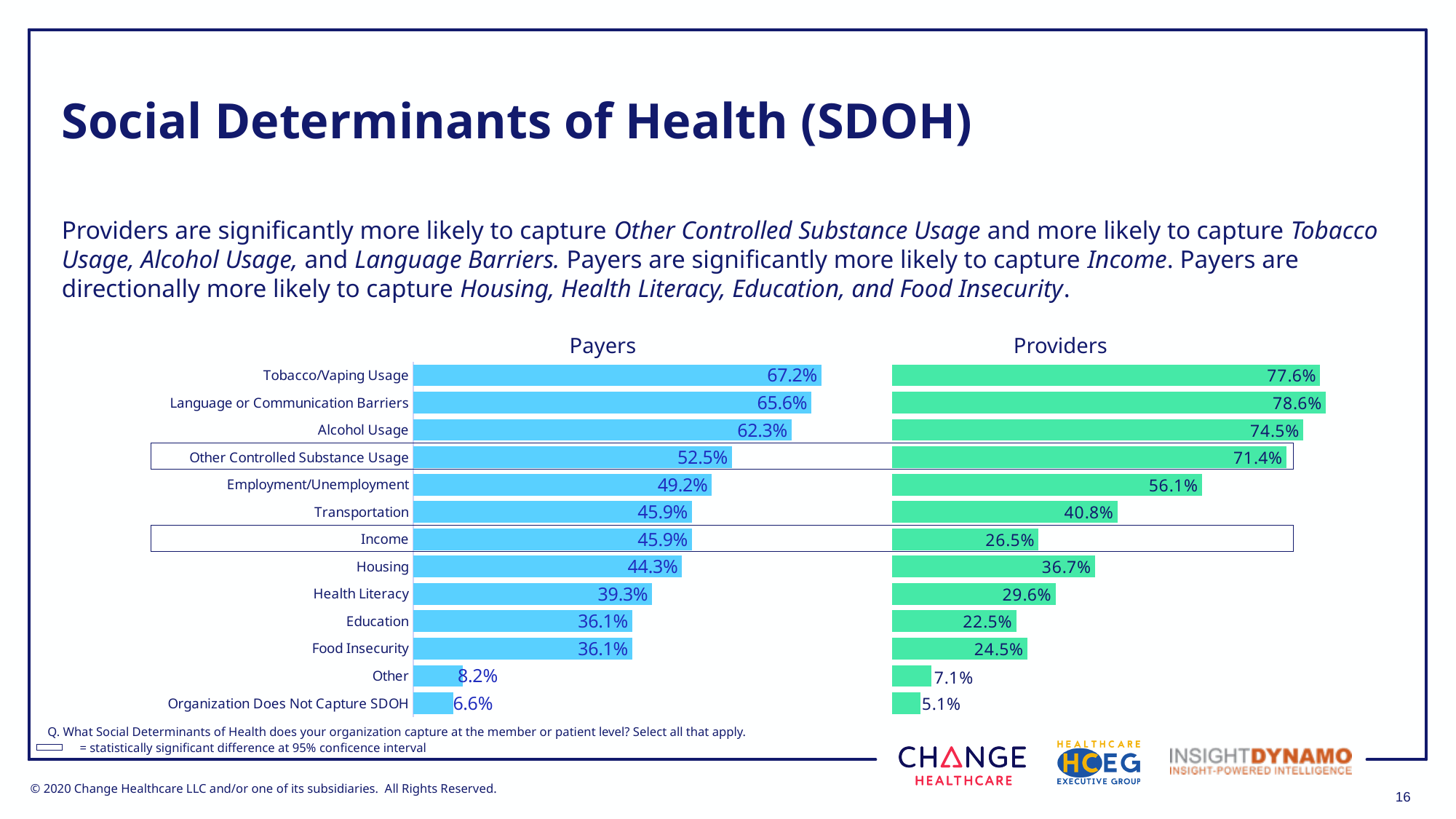
In the Providers chart, what percentage is shown for Income? 26.5% For Income, which is larger: the Payers value or the Providers value? Payers What is the difference between the Providers and Payers values for Other Controlled Substance Usage? 18.9 percentage points In the Providers chart, which category has the highest value? Language or Communication Barriers In the Providers chart, what percentage is shown for Employment/Unemployment? 56.1% What is the difference between the Payers and Providers values for Housing? 7.6 percentage points In the Payers chart, which category has the lowest value? Organization Does Not Capture SDOH How many categories are listed in the charts? 13 In the Payers chart, what percentage is shown for Tobacco/Vaping Usage? 67.2% What type of chart is used on this slide? Bar chart What colour are the bars in the Providers chart? Green In the Payers chart, what percentage is shown for Health Literacy? 39.3%